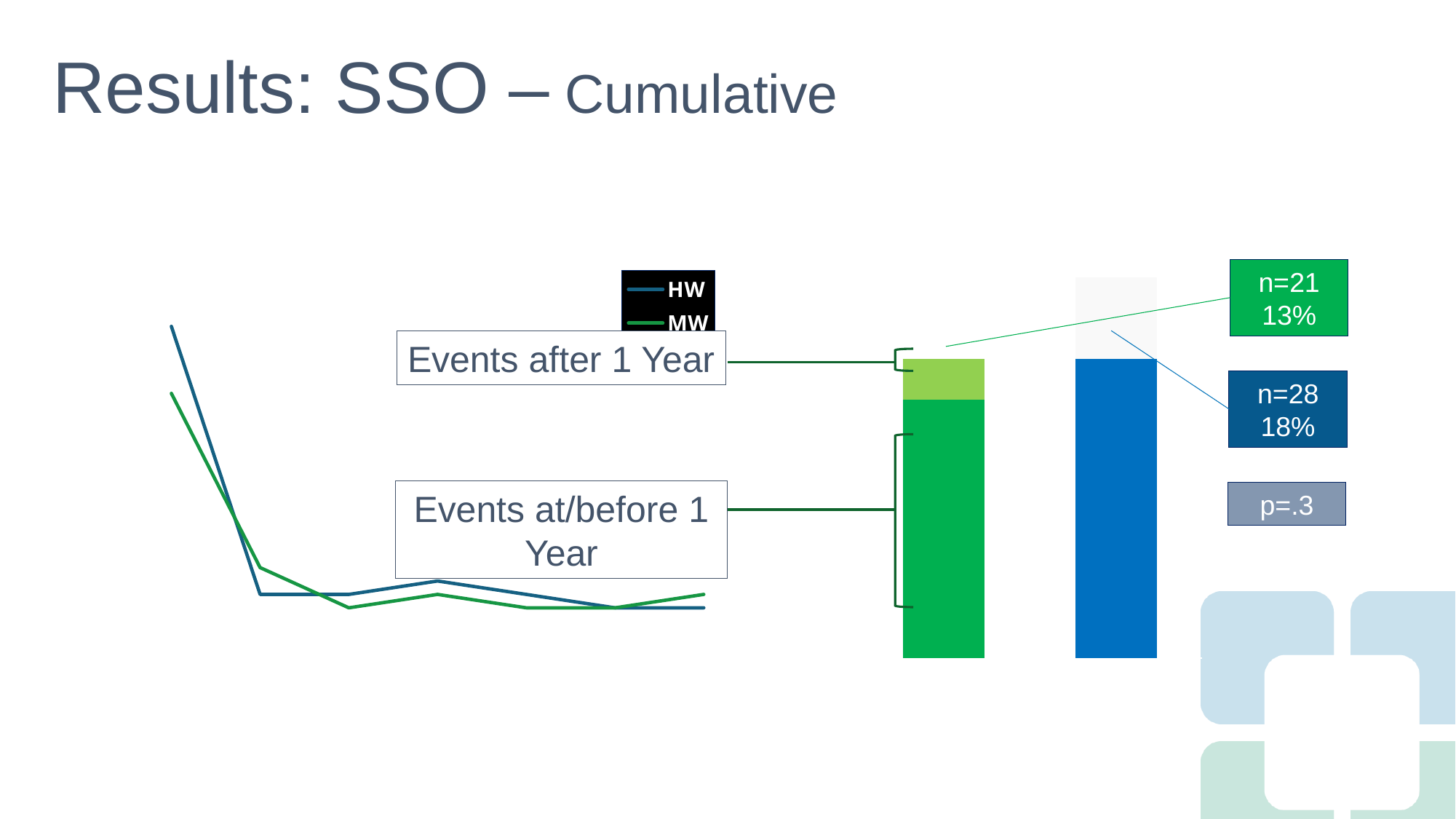
In the line chart on the left, how many series does the legend list? 2 In the bar chart on the right, what n value is annotated for the green bar? n=21 In the bar chart on the right, how many bars are there? 2 What kind of chart is the chart on the right of the slide, with the green and blue bars? bar chart What p-value is shown next to the bar chart on the right? p=.3 In the line chart on the left, what are the two series named in the legend? HW and MW In the bar chart on the right, what is the difference between the n values annotated for the blue bar and the green bar? 7 In the line chart on the left, do the lines generally rise or fall from left to right? fall In the bar chart on the right, which bar is taller, the green bar or the blue bar? the blue bar In the bar chart on the right, what percentage is annotated for the blue bar? 18% In the bar chart on the right, what is the difference between the percentages annotated for the blue bar (18%) and the green bar (13%)? 5% What kind of chart is the chart on the left of the slide? line chart